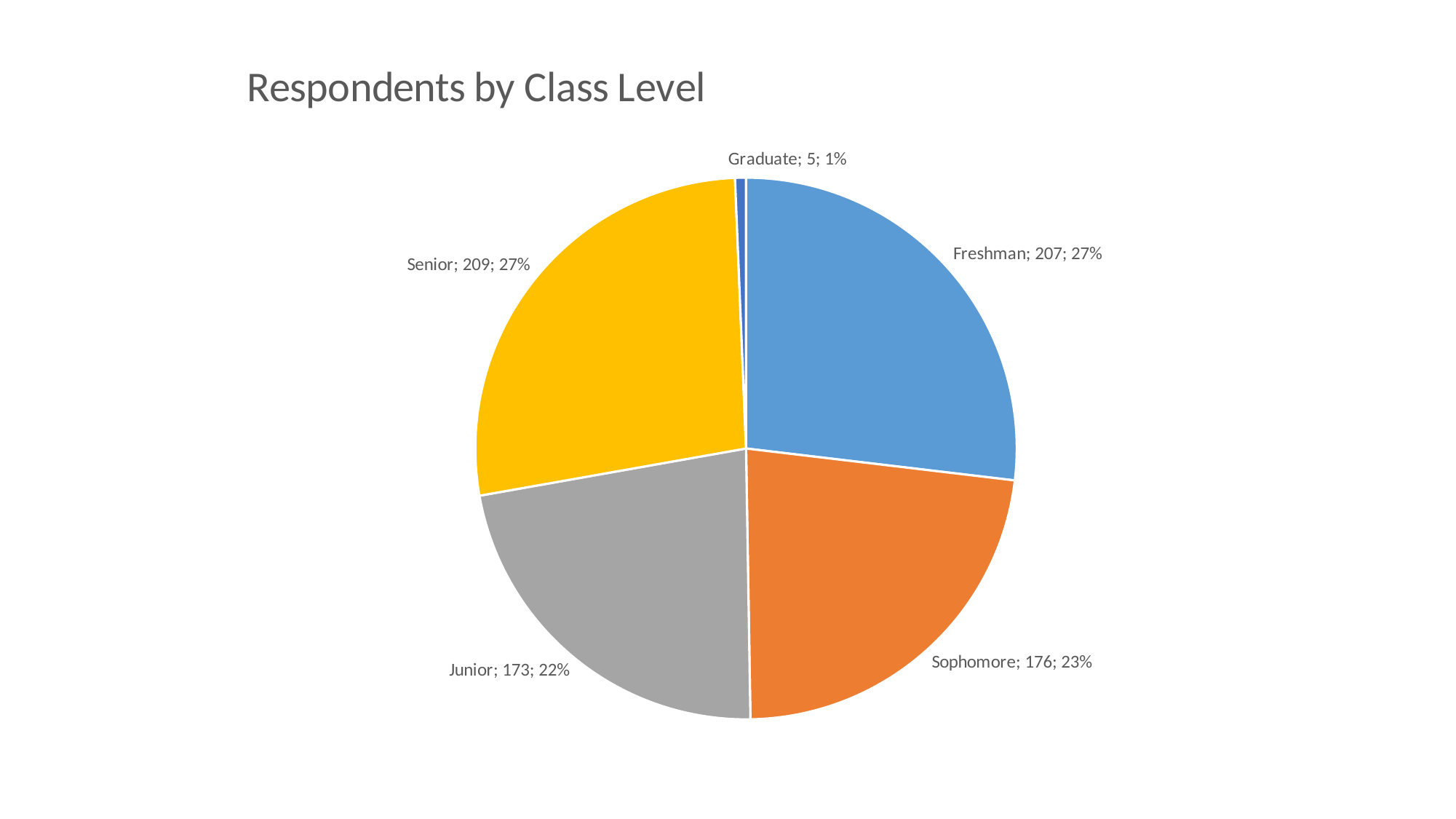
What is the difference between the number of Sophomore and Junior respondents? 3 Which class level has the most respondents? Senior What share of respondents are Senior? 27% Which has more respondents, Freshman or Sophomore? Freshman What share of respondents are Junior? 22% What type of chart is shown on the slide? pie chart What is the title of the chart? Respondents by Class Level How many respondents are Sophomore? 176 Which class level has the fewest respondents? Graduate How many class levels are shown in the pie chart? 5 How many respondents are Graduate? 5 How many respondents are Freshman? 207